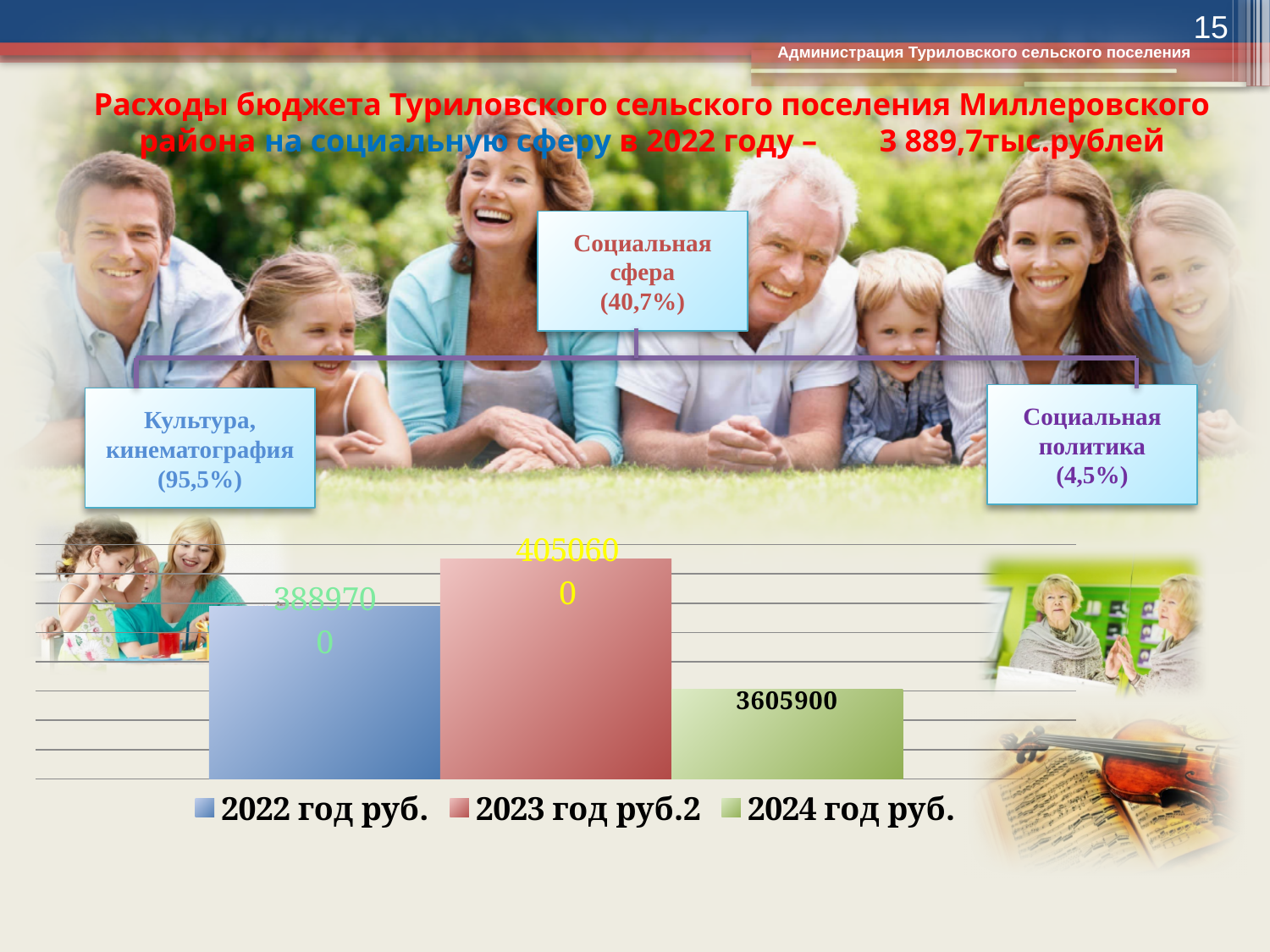
How many series does the legend list? 3 What kind of chart is shown on the slide? bar chart Which is larger, the value for 2022 год руб. or the value for 2024 год руб.? 2022 год руб. What is the difference between the 2022 год руб. value and the 2024 год руб. value? 283800 Which series has the highest value in the chart? 2023 год руб.2 Which series has the lowest value in the chart? 2024 год руб. What value is shown for the 2024 год руб. bar? 3605900 What colour is the bar for 2023 год руб.2? red What value is shown for the 2023 год руб.2 bar? 4050600 What is the difference between the 2023 год руб.2 value and the 2022 год руб. value? 160900 What is the difference between the 2023 год руб.2 value and the 2024 год руб. value? 444700 What value is shown for the 2022 год руб. bar? 3889700